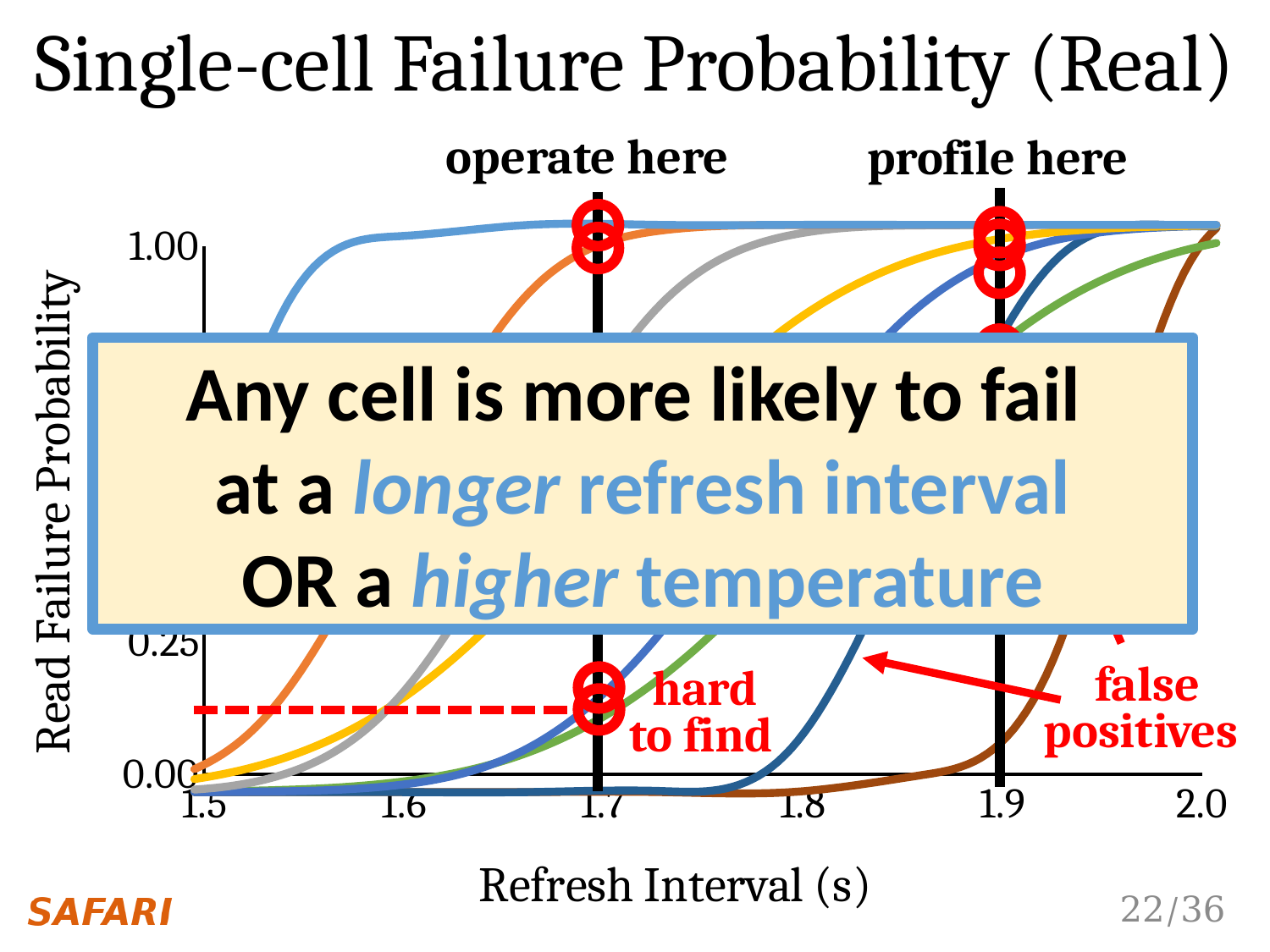
What is the highest value labelled on the y axis of the chart? 1.00 At which refresh interval is the vertical line annotated "operate here" drawn? 1.7 At which refresh interval is the vertical line annotated "profile here" drawn? 1.9 As the refresh interval increases along the x axis, do the plotted curves rise or fall? rise How many tick values are labelled on the x axis of the chart? 6 Which of the two annotated refresh intervals, "operate here" or "profile here", is the longer one? profile here What kind of chart is shown on the slide? line chart What is the label of the x axis of the chart? Refresh Interval (s) What is the title of the chart on the slide? Single-cell Failure Probability (Real) What is the smallest refresh interval labelled on the x axis? 1.5 What is the largest refresh interval labelled on the x axis? 2.0